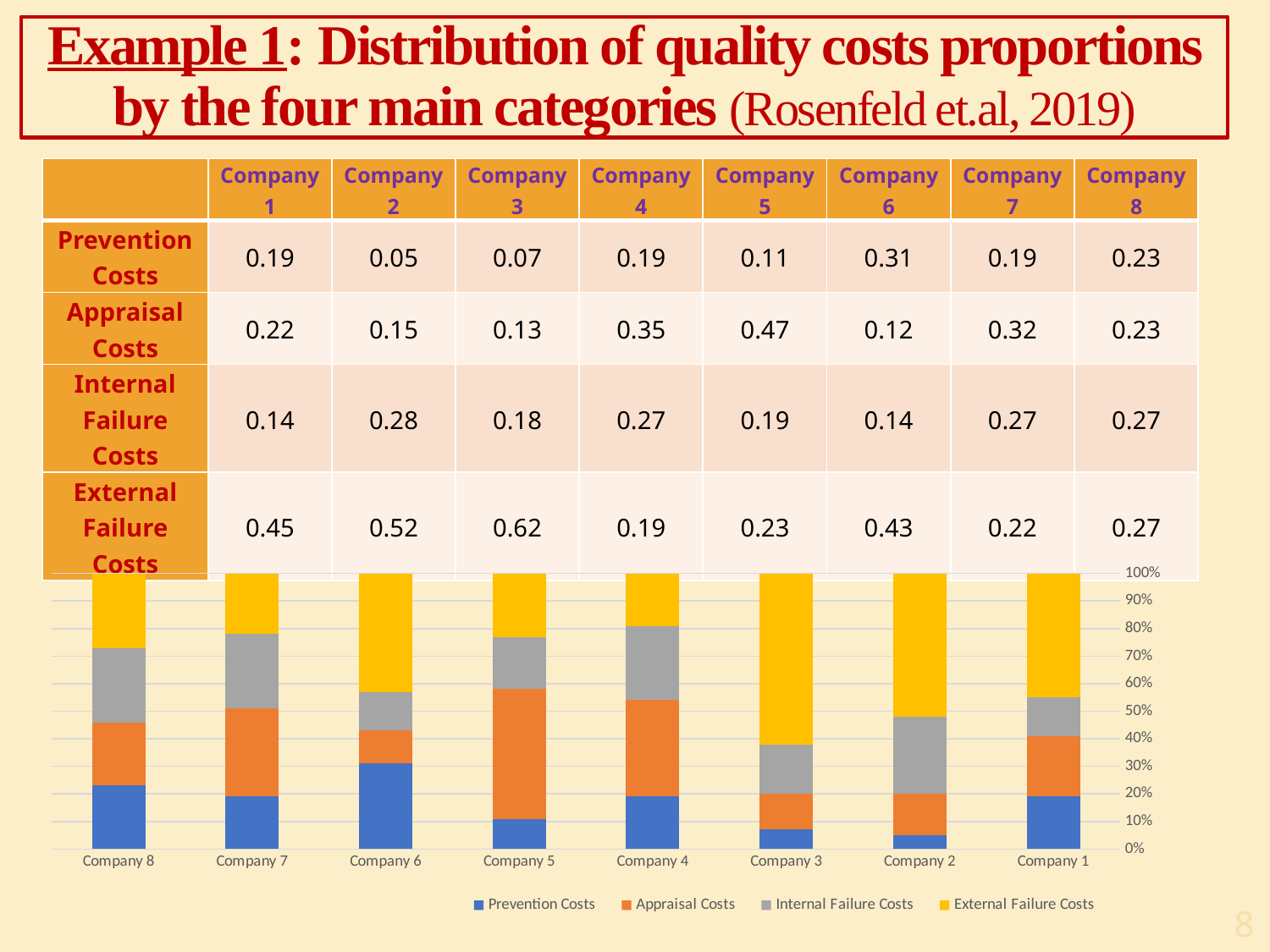
What is the difference between the External Failure Costs proportions of Company 3 and Company 4? 0.43 What kind of chart is shown at the bottom of the slide? Stacked bar chart In the chart, is the Prevention Costs value for Company 6 greater or less than 20%? greater How many series does the chart legend list? 4 Which series is shown in yellow in the chart? External Failure Costs Which company has the lowest Prevention Costs proportion? Company 2 What is the External Failure Costs proportion for Company 3? 0.62 How many companies are shown on the x axis of the chart? 8 Which company has the highest External Failure Costs proportion? Company 3 Which is larger, the Appraisal Costs proportion for Company 5 or for Company 6? Company 5 What is the Prevention Costs proportion for Company 6? 0.31 Which company is shown first (leftmost) on the chart's x axis? Company 8